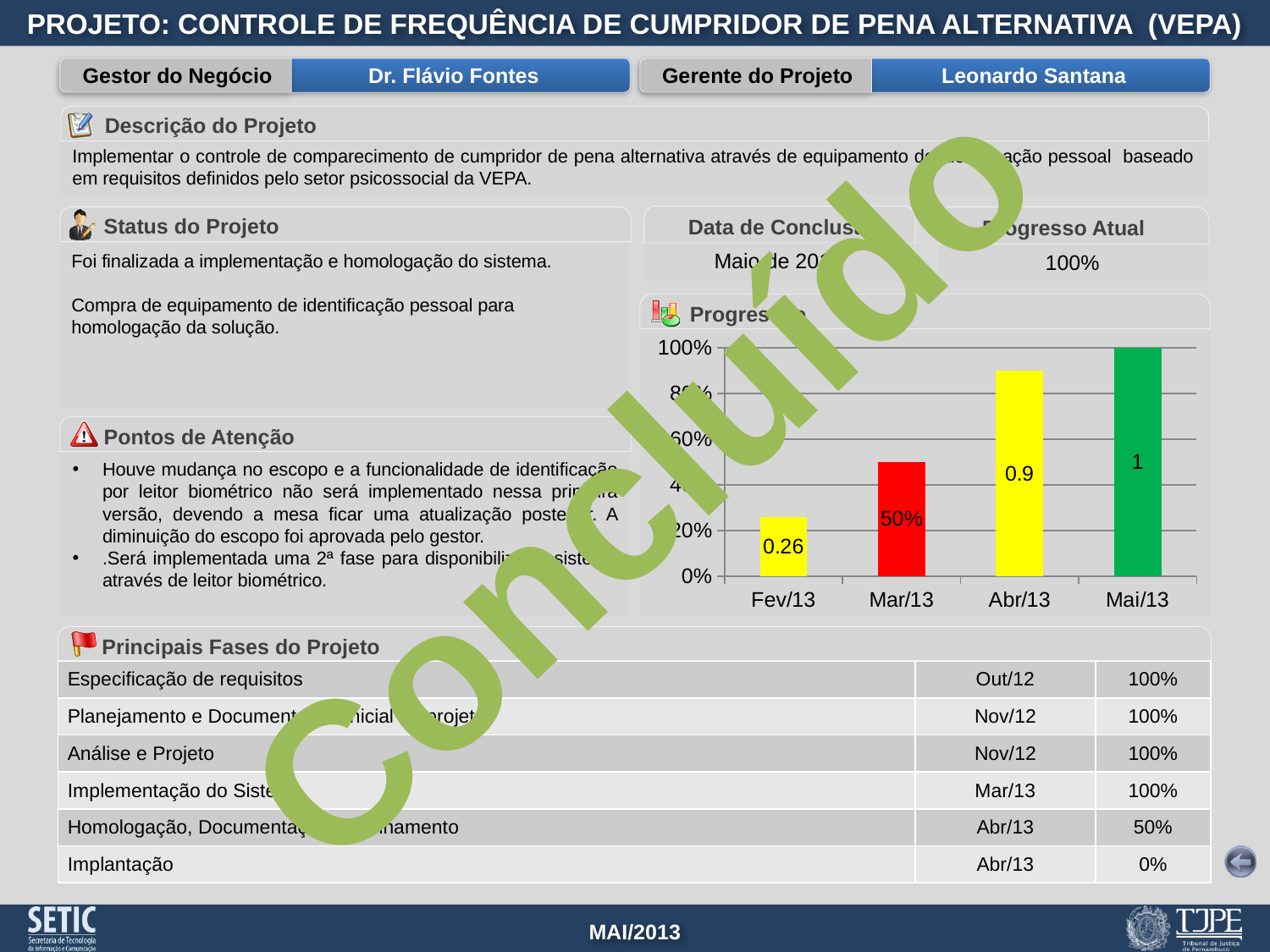
Which month has the highest bar in the progress chart? Mai/13 What kind of chart is used to show the project progress? Bar chart What is the value shown for Fev/13 in the progress bar chart? 0.26 How many months are plotted in the progress chart? 4 In the progress chart, which is larger, the value for Mar/13 or the value for Abr/13? Abr/13 Which month has the lowest bar in the progress chart? Fev/13 Is the value for Fev/13 in the progress chart greater or less than 20%? greater What is the value shown for Abr/13 in the progress bar chart? 0.9 What is the value shown for Mar/13 in the progress bar chart? 50% Do the values in the progress chart rise or fall from Fev/13 to Mai/13? Rise What is the value shown for Mai/13 in the progress bar chart? 1 What colour is the Mai/13 bar in the progress chart? Green